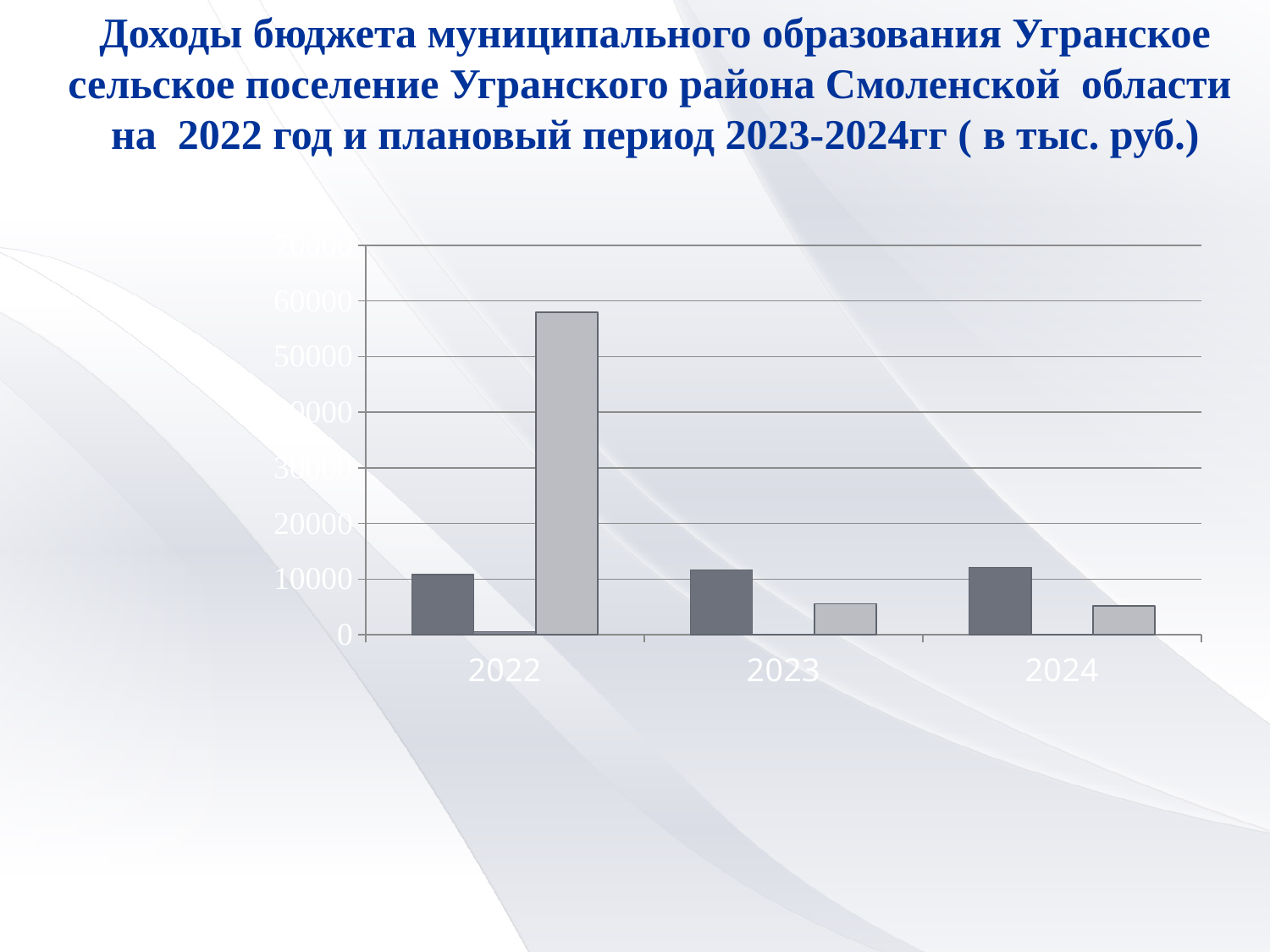
What kind of chart is shown on the slide? bar chart Is the value of the dark gray bar for 2022 greater or less than 20000? less In what units are the values given, according to the slide title? тыс. руб. For 2024, which bar is larger: the dark gray bar or the light gray bar? the dark gray bar Is the value of the tall light gray bar for 2022 greater or less than 50000? greater For 2022, which bar is larger: the dark gray bar or the light gray bar? the light gray bar Is the value of the light gray bar for 2024 greater or less than 10000? less What is the highest value shown on the y axis of the chart? 70000 How many years (categories) are shown on the x axis of the chart? 3 Which year contains the tallest bar in the chart? 2022 Do the dark gray bars rise or fall from 2022 to 2024? rise